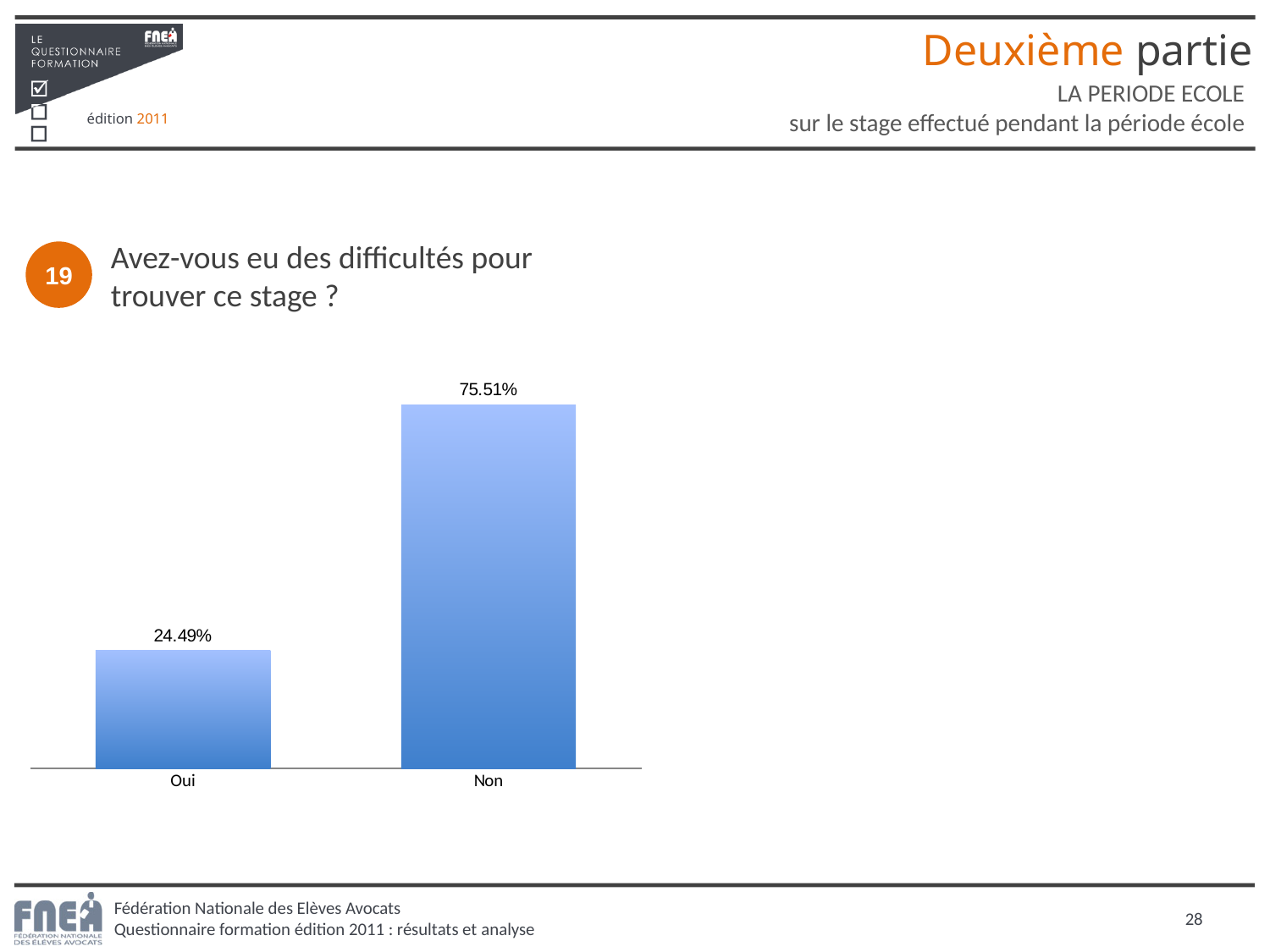
What is the value for Oui? 24.49% What is the difference between the values for Non and Oui? 51.02% Which category has the highest value? Non Which category has the lowest value? Oui What is the total of the two values shown in the chart? 100% What is the value for Non? 75.51% Which is larger, the value for Oui or the value for Non? Non What kind of chart is shown on the slide? Bar chart What are the two category labels on the x axis? Oui and Non How many categories are shown in the chart? 2 What question does the chart answer, according to the text next to the number 19? Avez-vous eu des difficultés pour trouver ce stage ?